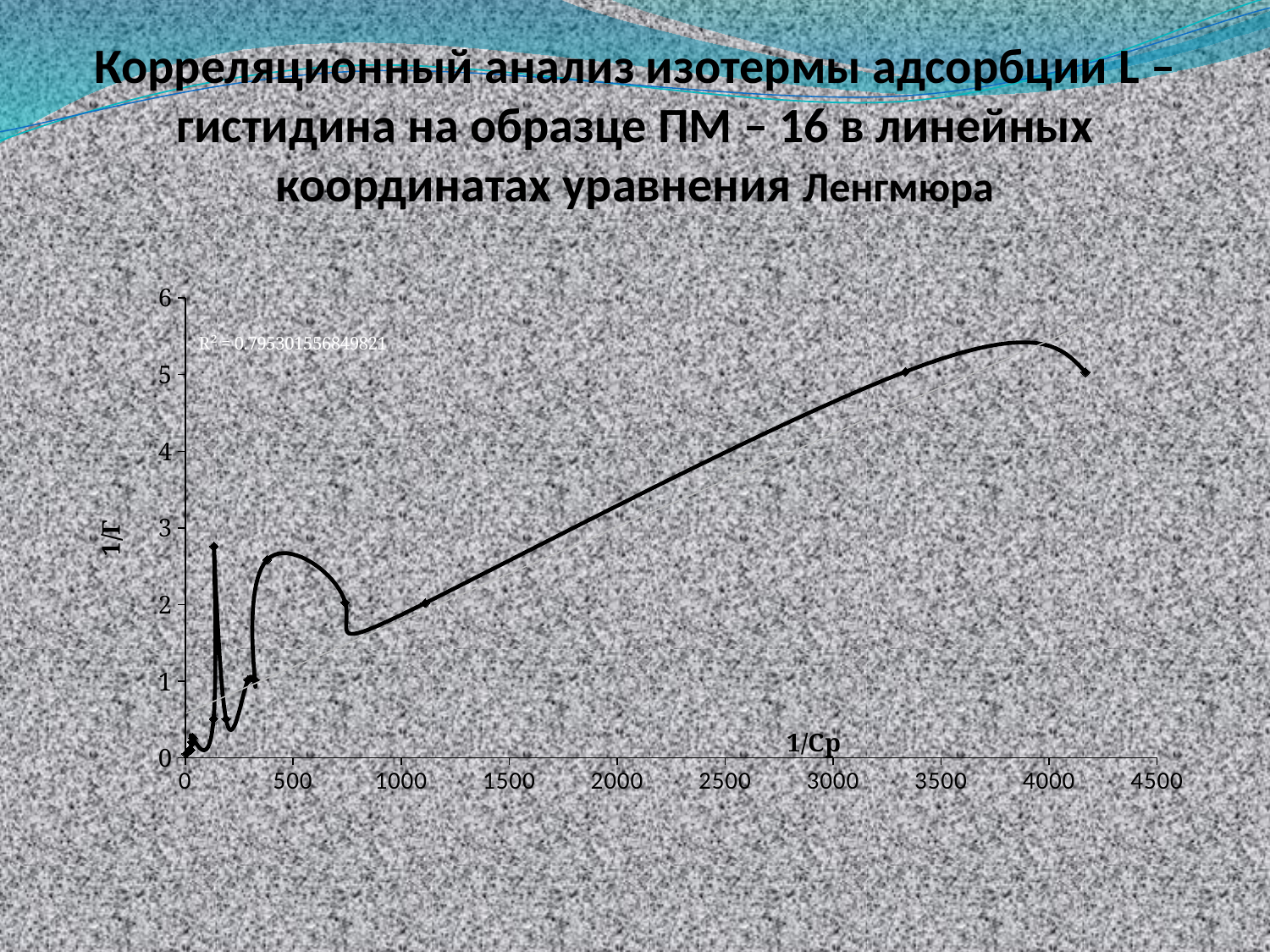
What is the highest tick value shown on the vertical axis? 6 What is the label of the horizontal axis? 1/Cp Is the value of 1/Г for the point near 1/Cp = 3300 greater or less than 4? greater What is the highest tick value shown on the horizontal axis? 4500 What R² value is printed on the chart? R² = 0.795301556849821 Is the value of 1/Г for the point near 1/Cp = 1100 greater or less than 3? less What is the label of the vertical axis? 1/Г Which has the larger 1/Г value: the point near 1/Cp = 3300 or the point near 1/Cp = 1100? The point near 1/Cp = 3300 Is the value of 1/Г for the rightmost point (near 1/Cp = 4150) greater or less than 4? greater Between 1/Cp = 1100 and 1/Cp = 3300, does the curve rise or fall? Rise What kind of chart is shown on the slide? Line chart (scatter with smoothed line)